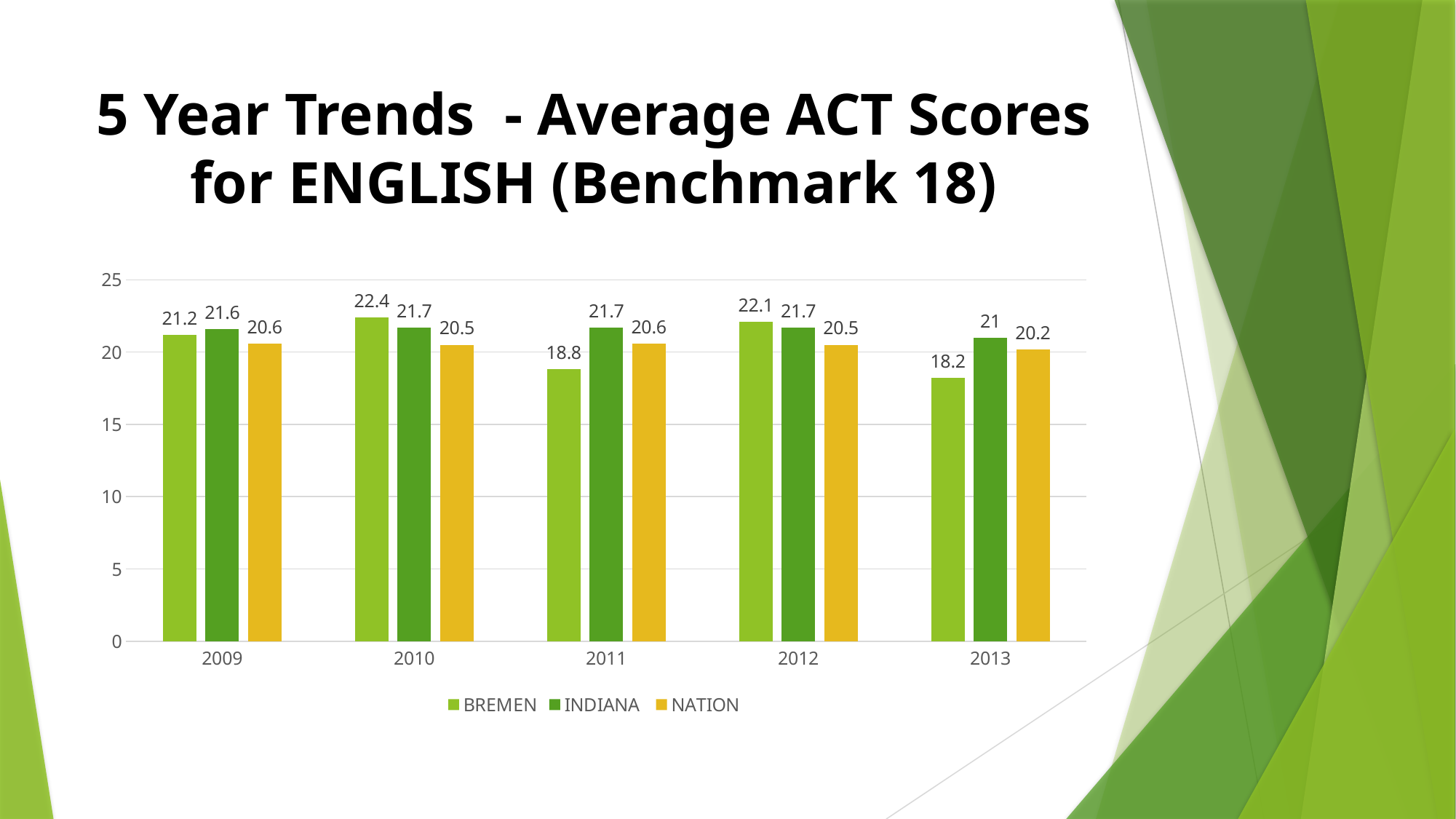
How many years are shown on the x axis? 5 In which year is the BREMEN value highest? 2010 Is the BREMEN value for 2013 greater or less than 20? less What is the NATION value for 2013? 20.2 How many series does the legend list? 3 What is the BREMEN value for 2010? 22.4 In which year is the BREMEN value lowest? 2013 Which is larger in 2012, the BREMEN value or the NATION value? BREMEN What is the difference between the INDIANA and BREMEN values in 2011? 2.9 What is the INDIANA value for 2011? 21.7 Which series is shown in yellow? NATION What kind of chart is shown on the slide? bar chart